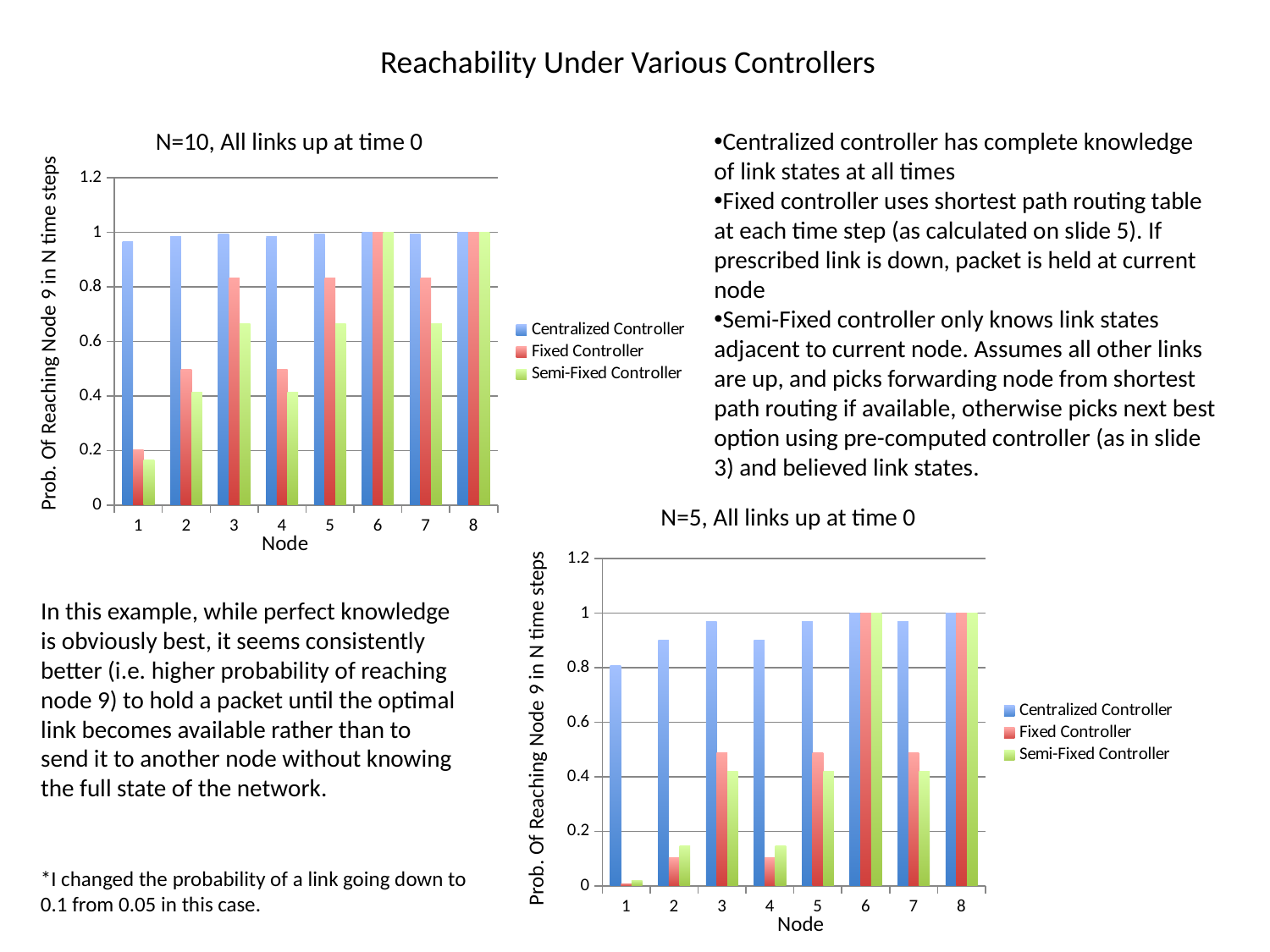
In the "N=10, All links up at time 0" chart, which node has the lowest Semi-Fixed Controller value? 1 In the "N=5, All links up at time 0" chart, is the Centralized Controller value for node 1 greater or less than 0.6? greater What is the y-axis label of the "N=5, All links up at time 0" chart? Prob. Of Reaching Node 9 in N time steps In the "N=10, All links up at time 0" chart, is the Fixed Controller value for node 1 greater or less than 0.4? less How many series does the legend of the "N=5, All links up at time 0" chart list? 3 In the "N=5, All links up at time 0" chart, is the Semi-Fixed Controller value for node 2 greater or less than 0.2? less In the "N=5, All links up at time 0" chart, which node has the lowest Centralized Controller value? 1 How many nodes are shown on the x axis of the "N=10, All links up at time 0" chart? 8 What kind of chart is the "N=10, All links up at time 0" chart? bar chart In the "N=5, All links up at time 0" chart, which series has the higher value for node 4: Fixed Controller or Semi-Fixed Controller? Semi-Fixed Controller In the "N=10, All links up at time 0" chart, which series has the higher value for node 3: Fixed Controller or Semi-Fixed Controller? Fixed Controller